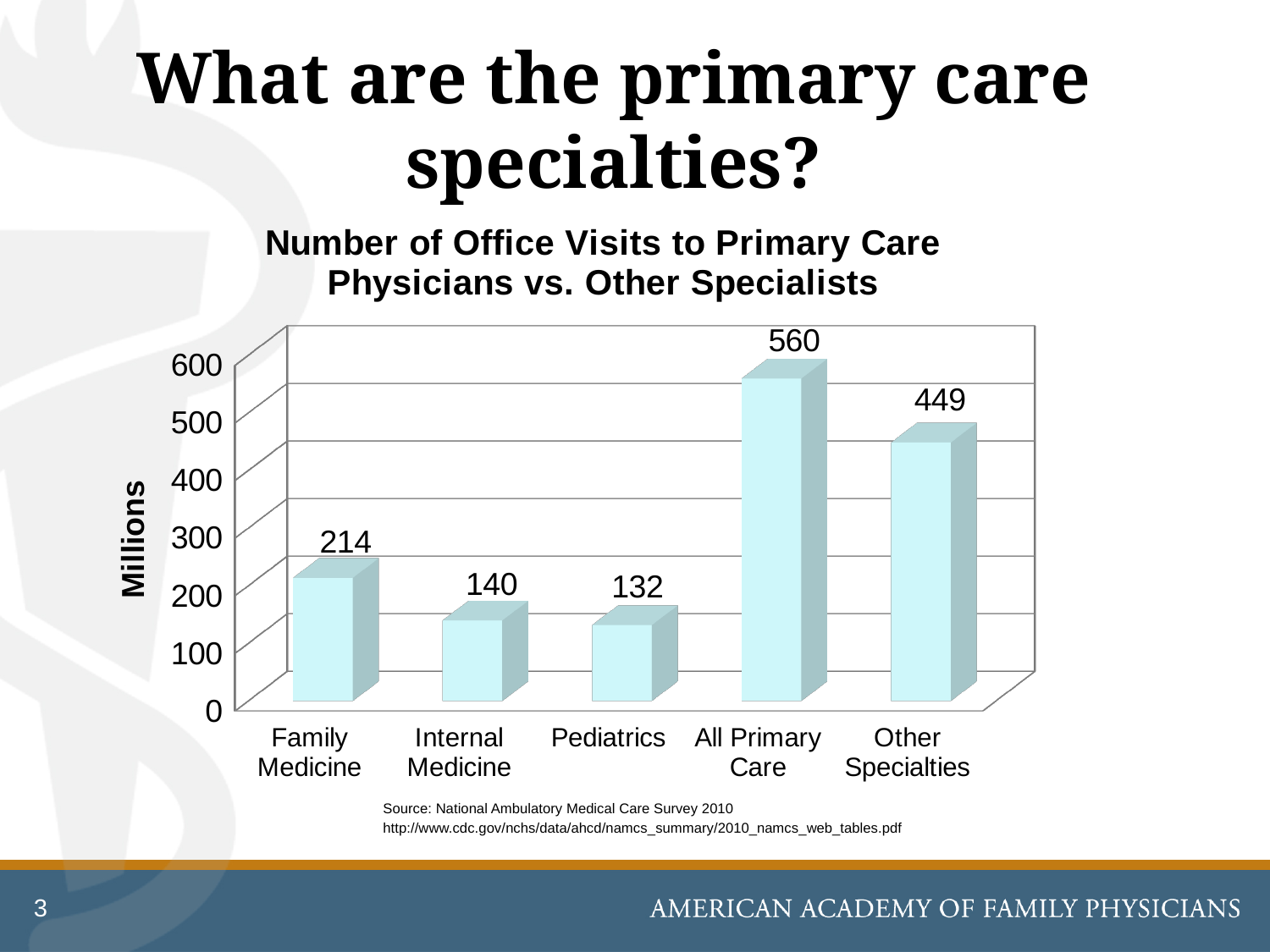
What is the label on the vertical axis of the chart? Millions What is the value shown for Other Specialties? 449 Which is larger, Family Medicine or Pediatrics? Family Medicine What is the value shown for Pediatrics? 132 What is the number of office visits (in millions) for Family Medicine? 214 What is the difference between All Primary Care and Other Specialties? 111 Which category has the highest number of office visits? All Primary Care What is the value shown for Internal Medicine? 140 What is the difference between Family Medicine and Internal Medicine? 74 What kind of chart is shown on the slide? Bar chart How many categories are shown on the x axis? 5 Which category has the lowest number of office visits? Pediatrics